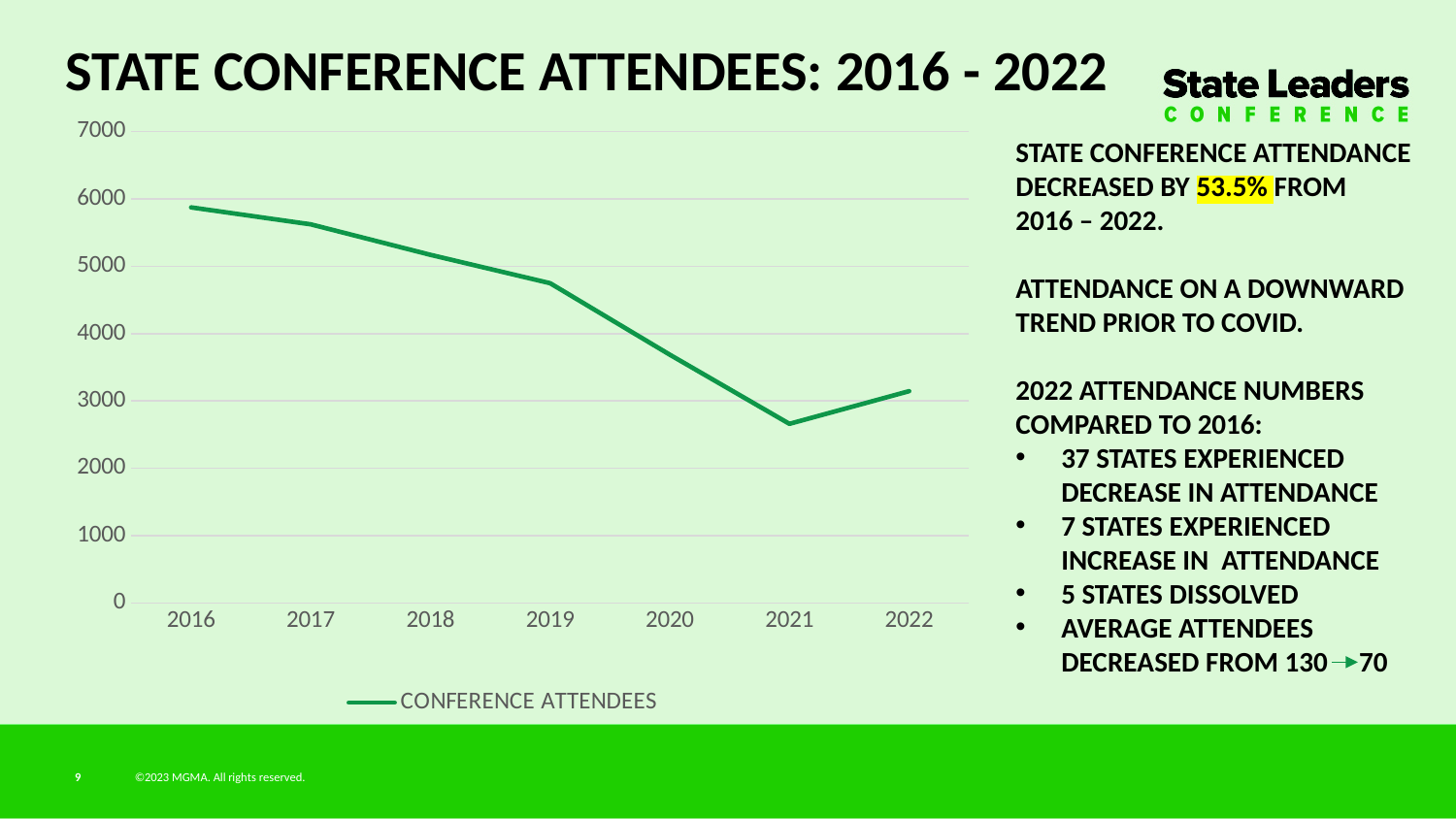
Which year has more conference attendees, 2019 or 2022? 2019 Is the value for 2021 greater or less than 3000? less Is the value for 2016 greater or less than 5000? greater How many years are plotted on the x axis of the chart? 7 What kind of chart is shown on the slide? line chart Is the value for 2020 greater or less than 4000? less What series name is shown in the chart legend? CONFERENCE ATTENDEES Which year has the highest number of conference attendees? 2016 Do conference attendees rise or fall from 2016 to 2021? fall How many series does the chart legend list? 1 What is the title of the chart? STATE CONFERENCE ATTENDEES: 2016 - 2022 Which year has the lowest number of conference attendees? 2021